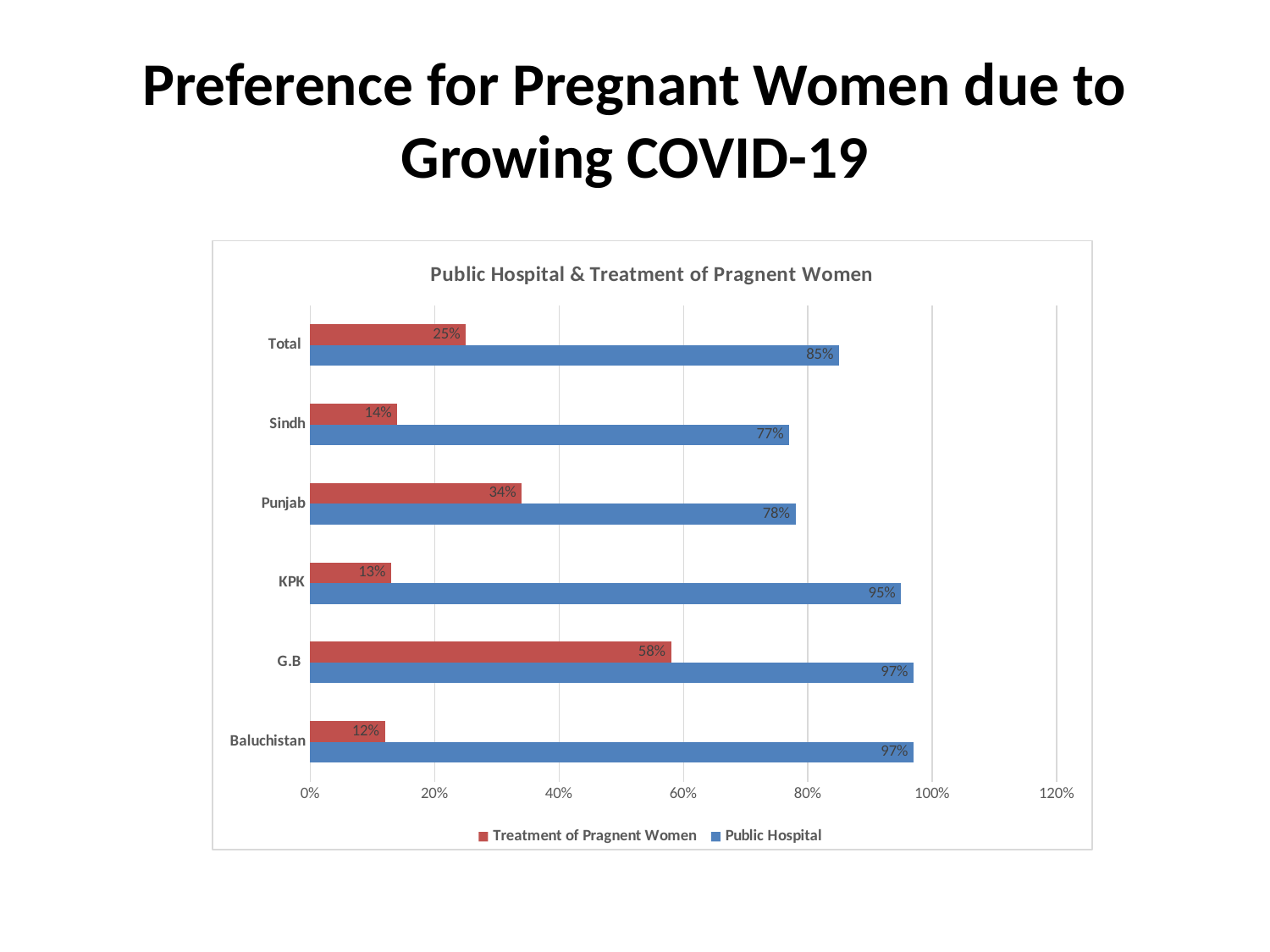
How many series does the legend list? 2 How many categories are shown on the chart? 6 What is the Public Hospital value for KPK? 95% Which category has the highest Treatment of Pragnent Women value? G.B What kind of chart is shown on the slide? Bar chart Which category has the lowest Public Hospital value? Sindh What is the Treatment of Pragnent Women value for G.B? 58% What is the Treatment of Pragnent Women value for Total? 25% What is the title of the chart? Public Hospital & Treatment of Pragnent Women Which category has the lowest Treatment of Pragnent Women value? Baluchistan What is the difference between the Public Hospital and Treatment of Pragnent Women values for Punjab? 44% Which is larger: the Treatment of Pragnent Women value for Punjab or for Sindh? Punjab